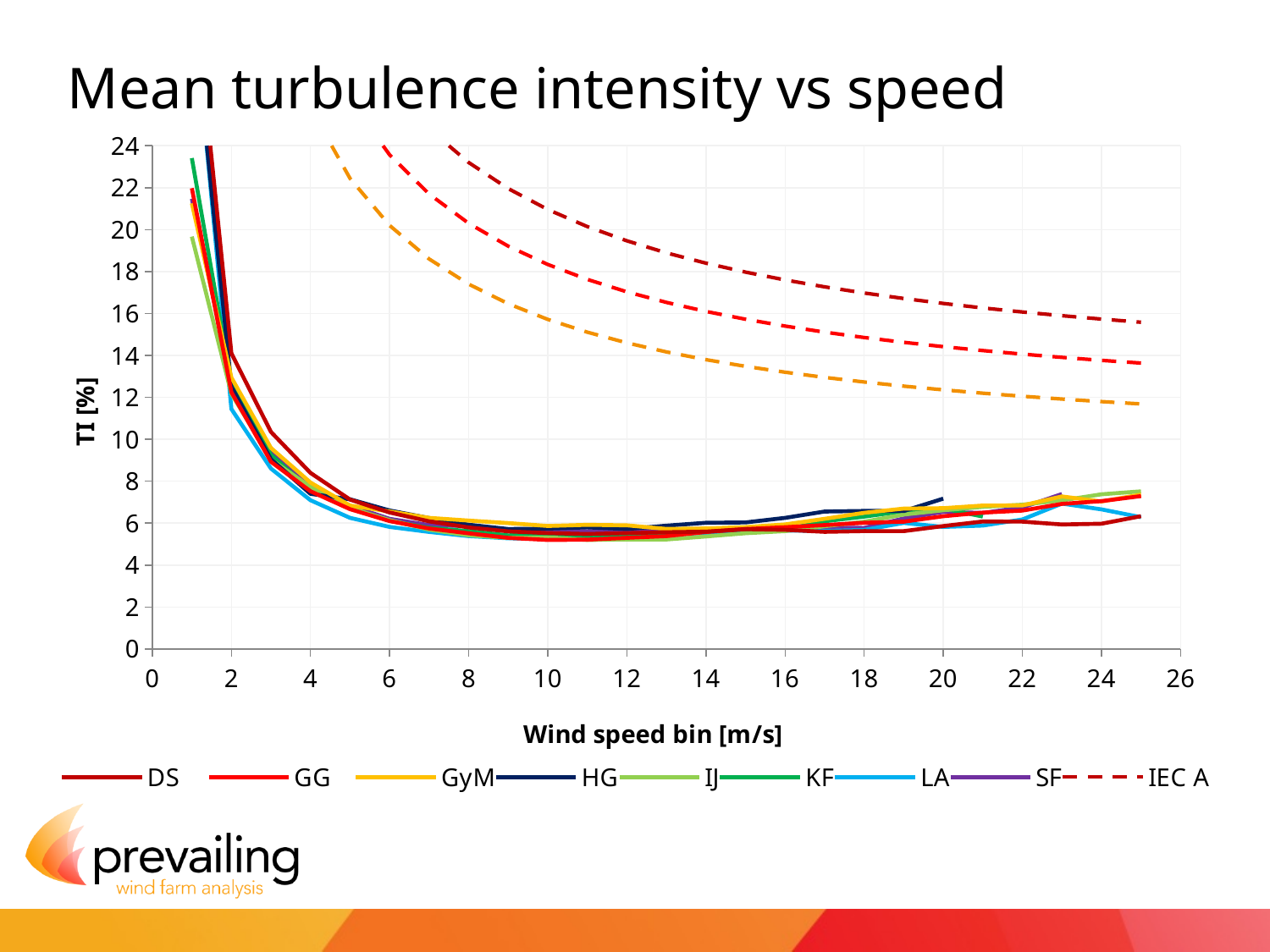
Is the value for the GG series at a wind speed bin of 1 m/s greater or less than 20? greater What is the title of the chart? Mean turbulence intensity vs speed Is the value for the HG series at a wind speed bin of 20 m/s greater or less than 6? greater How many series does the legend list? 9 Do the IEC A dashed lines rise or fall as wind speed increases? fall Are the IEC A dashed lines at a wind speed bin of 10 m/s greater or less than 12? greater What kind of chart is shown on the slide? line chart What is the label of the x axis? Wind speed bin [m/s] How many solid-line (non-dashed) series does the legend list? 8 Do the solid series values rise or fall as wind speed increases from 2 m/s to 6 m/s? fall